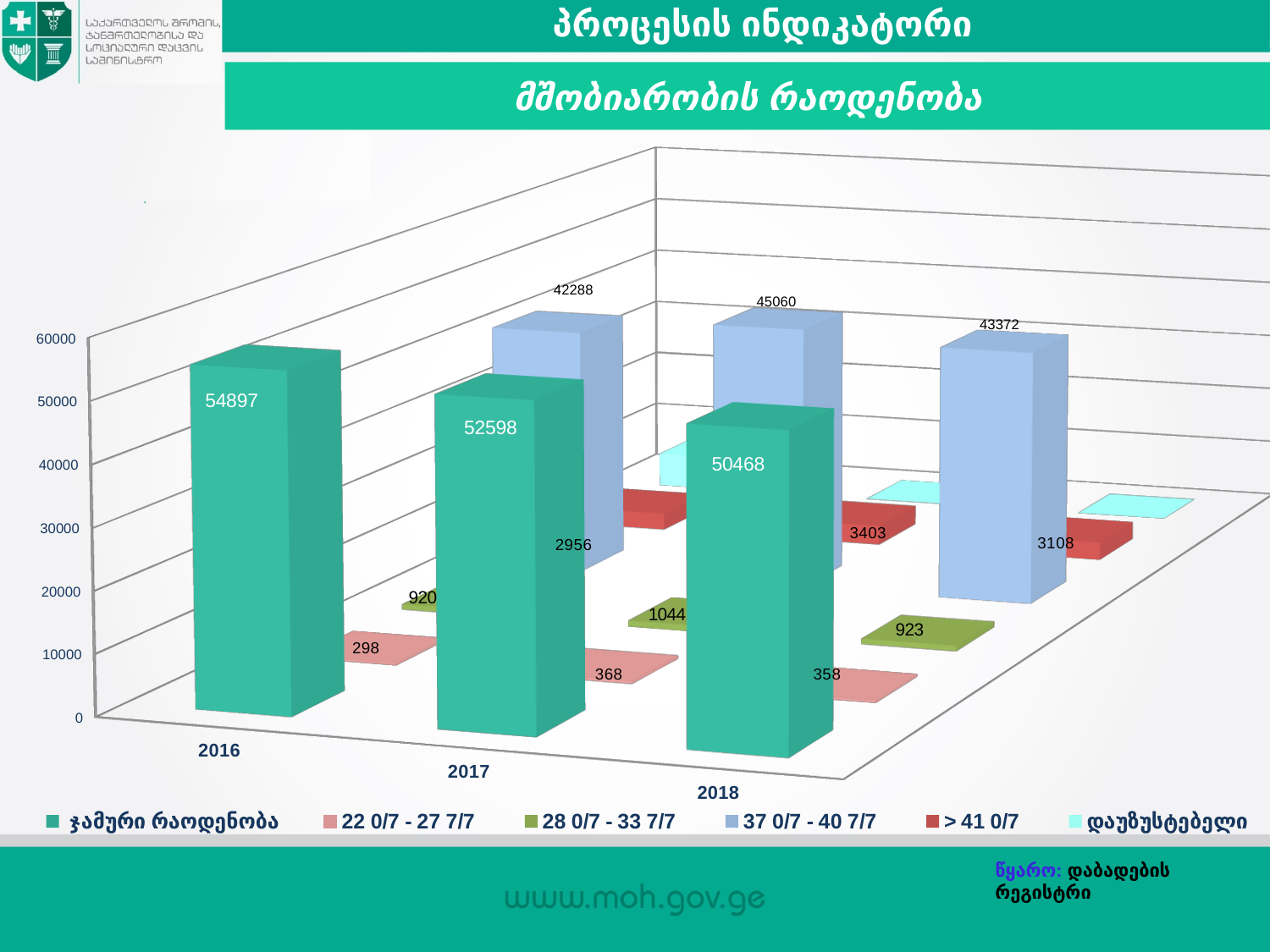
What is the value of ჯამური რაოდენობა for 2016? 54897 What is the value of the > 41 0/7 series for 2018? 3108 Which year has the highest value for ჯამური რაოდენობა? 2016 What is the difference between the ჯამური რაოდენობა values for 2016 and 2018? 4429 What type of chart is shown on the slide? Bar chart How many series does the legend list? 6 What is the value of the 28 0/7 - 33 7/7 series for 2018? 923 Which year has the lowest value for the 37 0/7 - 40 7/7 series? 2016 How does ჯამური რაოდენობა change from 2016 to 2018? It falls What is the value of the 22 0/7 - 27 7/7 series for 2017? 368 What is the value of the 37 0/7 - 40 7/7 series for 2017? 45060 Which is larger: the > 41 0/7 value for 2017 or for 2016? 2017